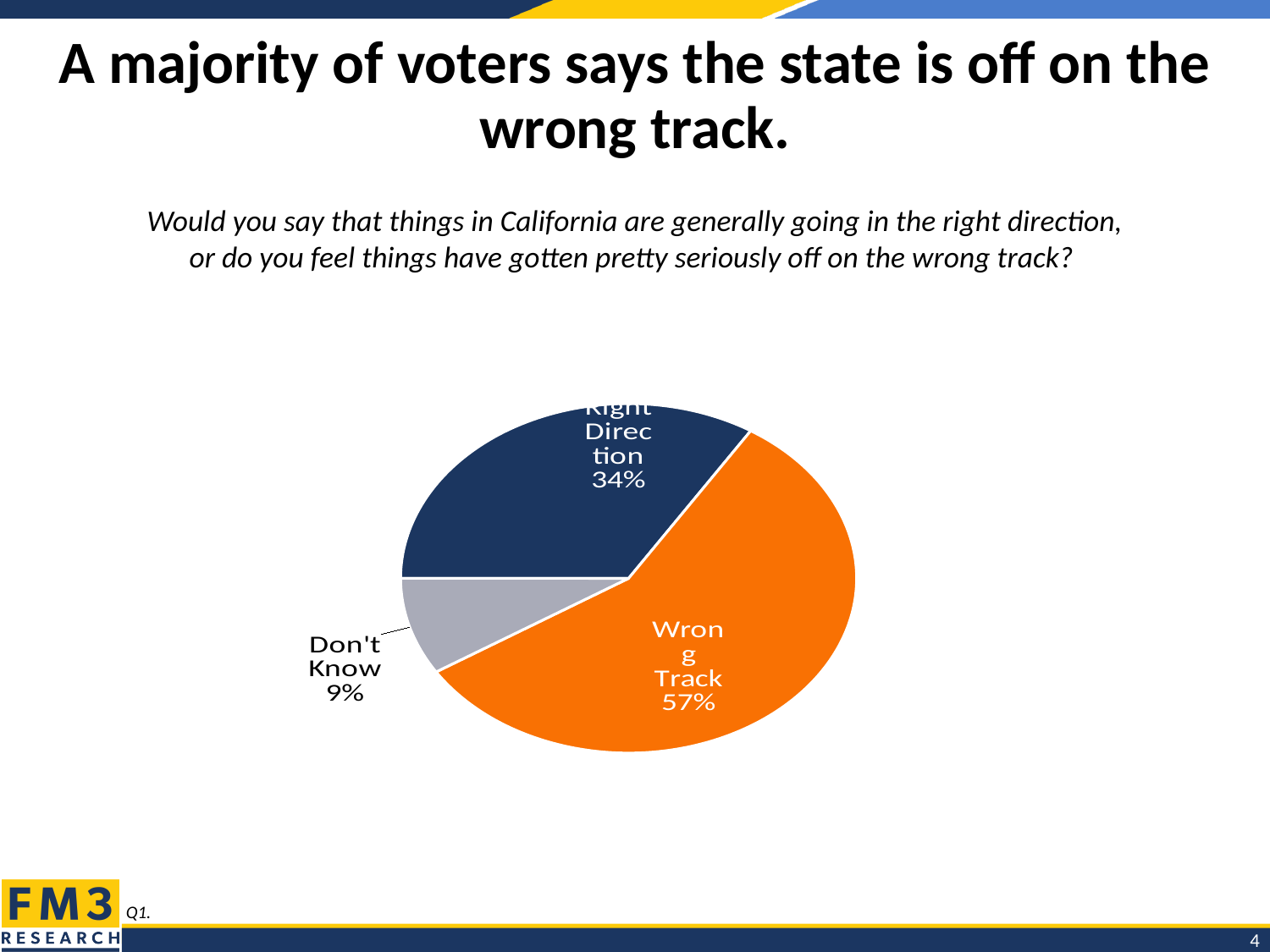
What colour is the Don't Know slice? Gray What percentage of voters say the state is going in the right direction? 34% Which is larger, the Right Direction share or the Don't Know share? Right Direction How many percentage points larger is Wrong Track than Right Direction? 23 What kind of chart is shown on the slide? Pie chart Which response has the largest share of the pie? Wrong Track What percentage of voters say the state is on the wrong track? 57% Which response has the smallest share of the pie? Don't Know How many slices does the pie chart have? 3 What colour is the Wrong Track slice? Orange What share of voters answered Don't Know? 9%